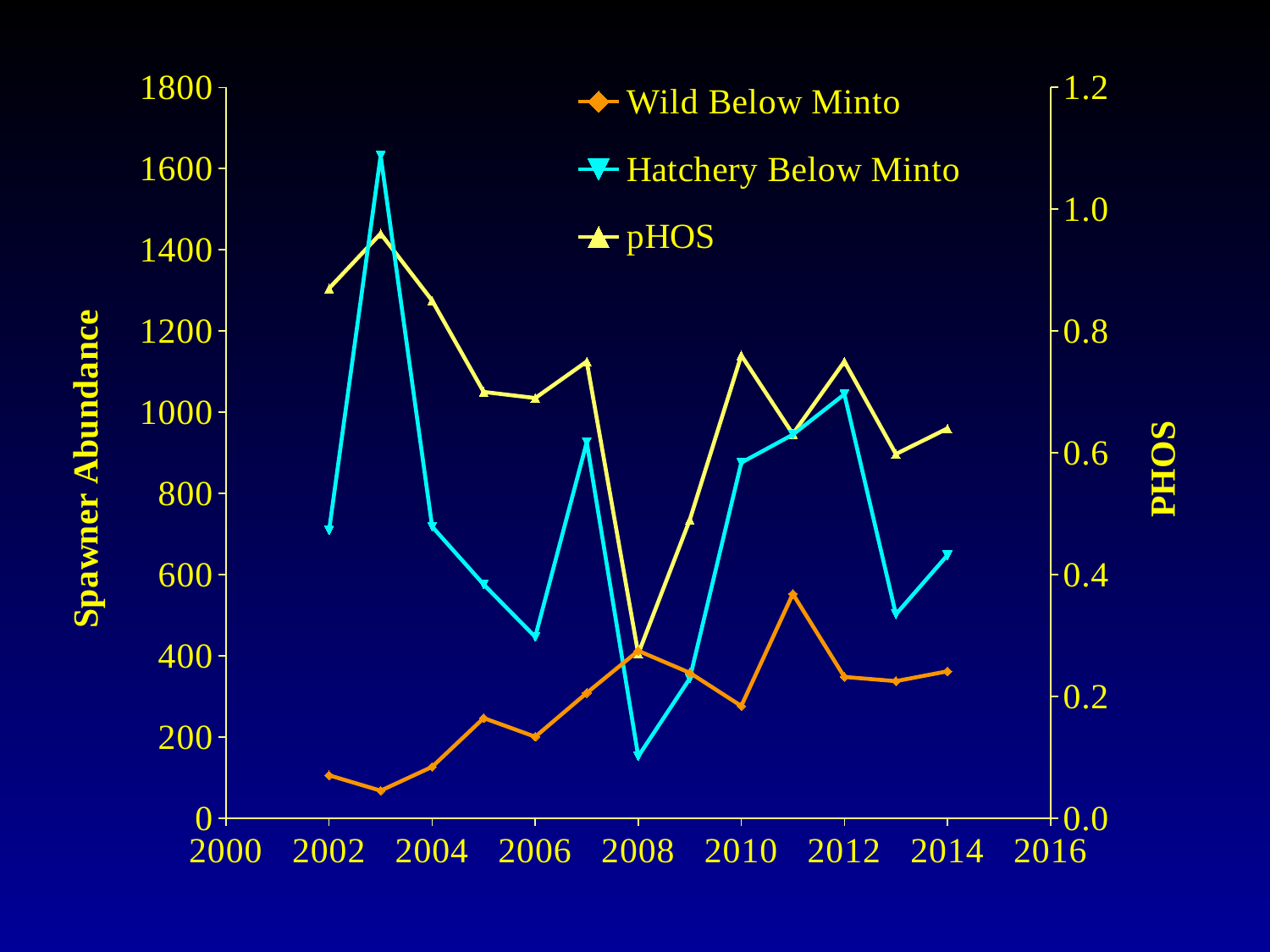
In which year does the Hatchery Below Minto series reach its lowest value? 2008 What is the title of the right-hand vertical axis? PHOS Is the Hatchery Below Minto value for 2003 greater or less than 1400? greater What kind of chart is shown on the slide? line chart In which year does the Wild Below Minto series reach its highest value? 2011 In 2008, which is larger: Wild Below Minto or Hatchery Below Minto? Wild Below Minto Is the pHOS value for 2003 greater or less than 0.8? greater Is the Hatchery Below Minto value for 2008 greater or less than 200? less In which year does the Hatchery Below Minto series reach its highest value? 2003 How many data points does the Wild Below Minto series have? 13 How many series does the legend list? 3 In which year does the pHOS series reach its lowest value? 2008